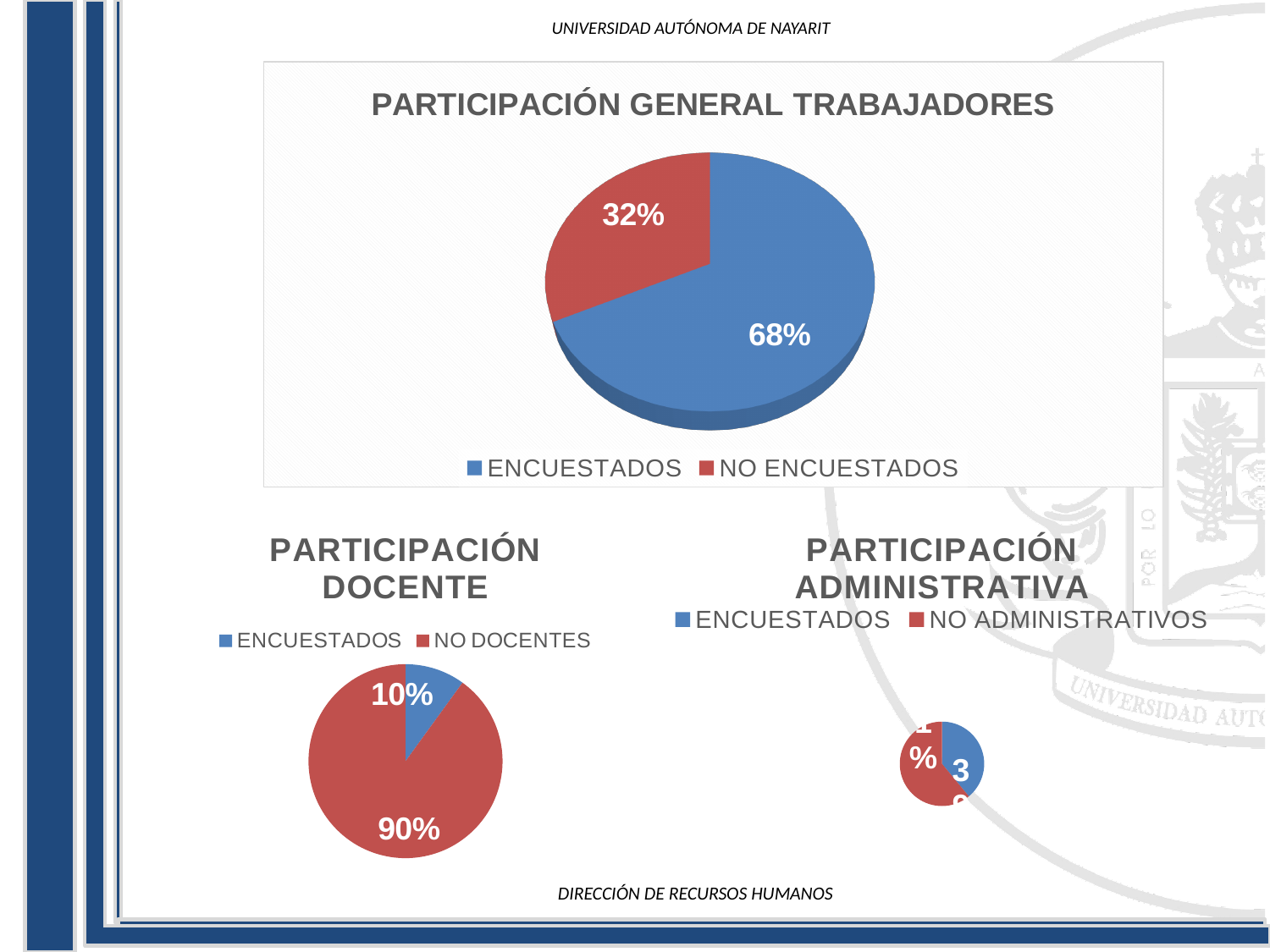
In the PARTICIPACIÓN GENERAL TRABAJADORES chart, which category has the larger share? ENCUESTADOS In the PARTICIPACIÓN GENERAL TRABAJADORES chart, what percentage is shown for NO ENCUESTADOS? 32% What are the two legend entries of the PARTICIPACIÓN ADMINISTRATIVA chart? ENCUESTADOS and NO ADMINISTRATIVOS In the PARTICIPACIÓN DOCENTE chart, what percentage is shown for NO DOCENTES? 90% In the PARTICIPACIÓN DOCENTE chart, what percentage is shown for ENCUESTADOS? 10% In the PARTICIPACIÓN DOCENTE chart, which category has the smaller share? ENCUESTADOS How many pie charts are shown on the slide? 3 In the PARTICIPACIÓN GENERAL TRABAJADORES chart, what is the difference in percentage points between ENCUESTADOS and NO ENCUESTADOS? 36 What type of chart is the PARTICIPACIÓN GENERAL TRABAJADORES chart? Pie chart In the PARTICIPACIÓN GENERAL TRABAJADORES chart, what percentage is shown for ENCUESTADOS? 68% In the PARTICIPACIÓN DOCENTE chart, how many slices does the pie have? 2 In the PARTICIPACIÓN ADMINISTRATIVA chart, which is larger: the ENCUESTADOS slice or the NO ADMINISTRATIVOS slice? NO ADMINISTRATIVOS